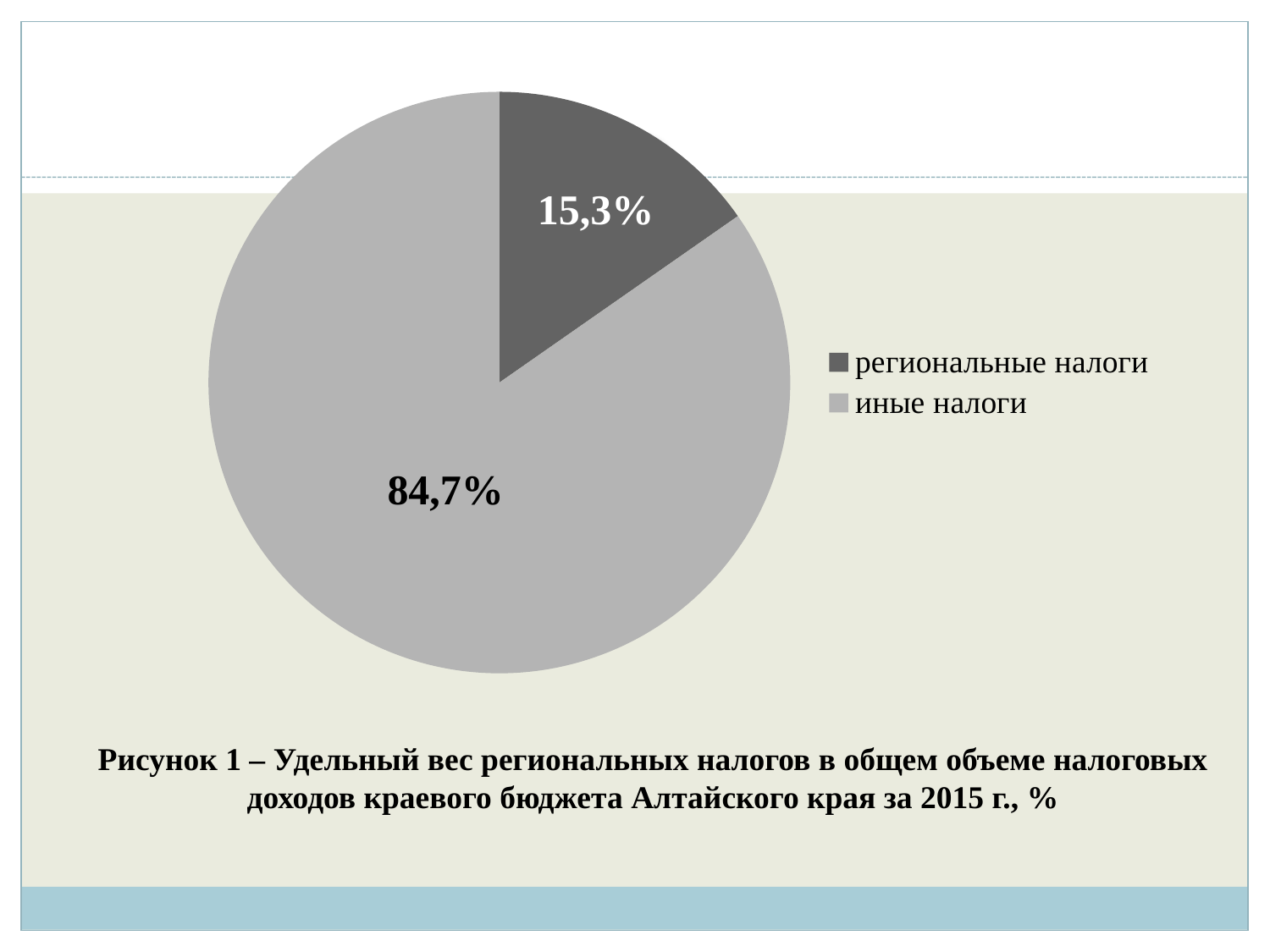
How many slices does the pie chart have? 2 What is the difference in percentage points between the иные налоги slice and the региональные налоги slice? 69,4 Which legend entry is shown in the darker grey colour? региональные налоги What kind of chart is shown on the slide? pie chart What is the total of the two slice labels shown on the pie? 100% How many entries does the legend list? 2 Which category has the largest slice of the pie? иные налоги Which category has the smallest slice of the pie? региональные налоги What share of the pie is labelled for региональные налоги? 15,3% Which is larger: the slice for региональные налоги or the slice for иные налоги? иные налоги What share of the pie is labelled for иные налоги? 84,7% For which year does the figure caption say the data is given? 2015